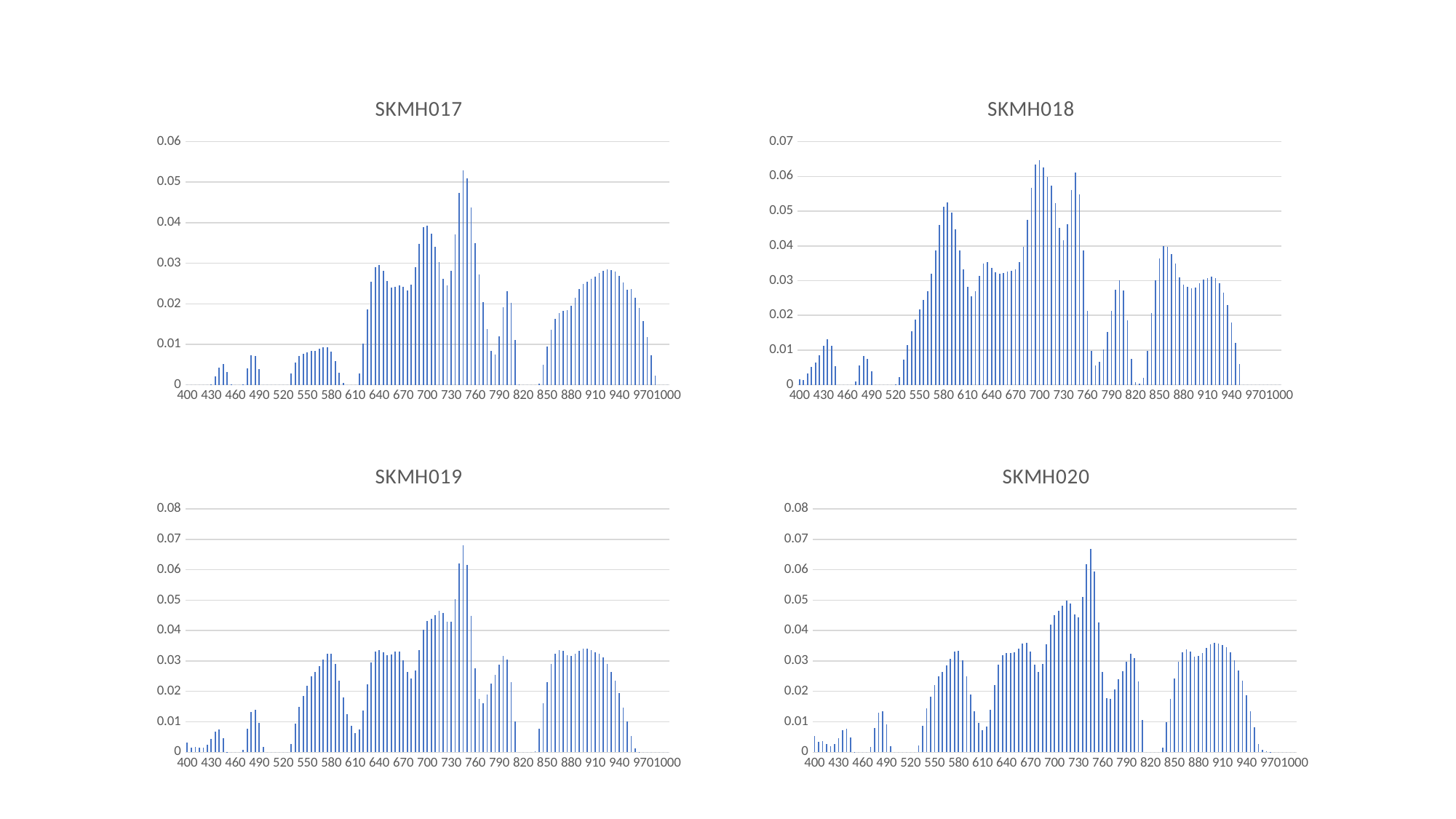
In the SKMH019 chart, is the value at 580 greater or less than 0.02? greater In the SKMH019 chart, is the tallest bar greater or less than 0.06? greater What is the title of the chart in the top-left position? SKMH017 In the SKMH018 chart, is the value at 700 greater or less than 0.05? greater What is the highest value shown on the y axis of the SKMH017 chart? 0.06 How many charts are shown on the slide? 4 What kind of chart is SKMH017? bar chart